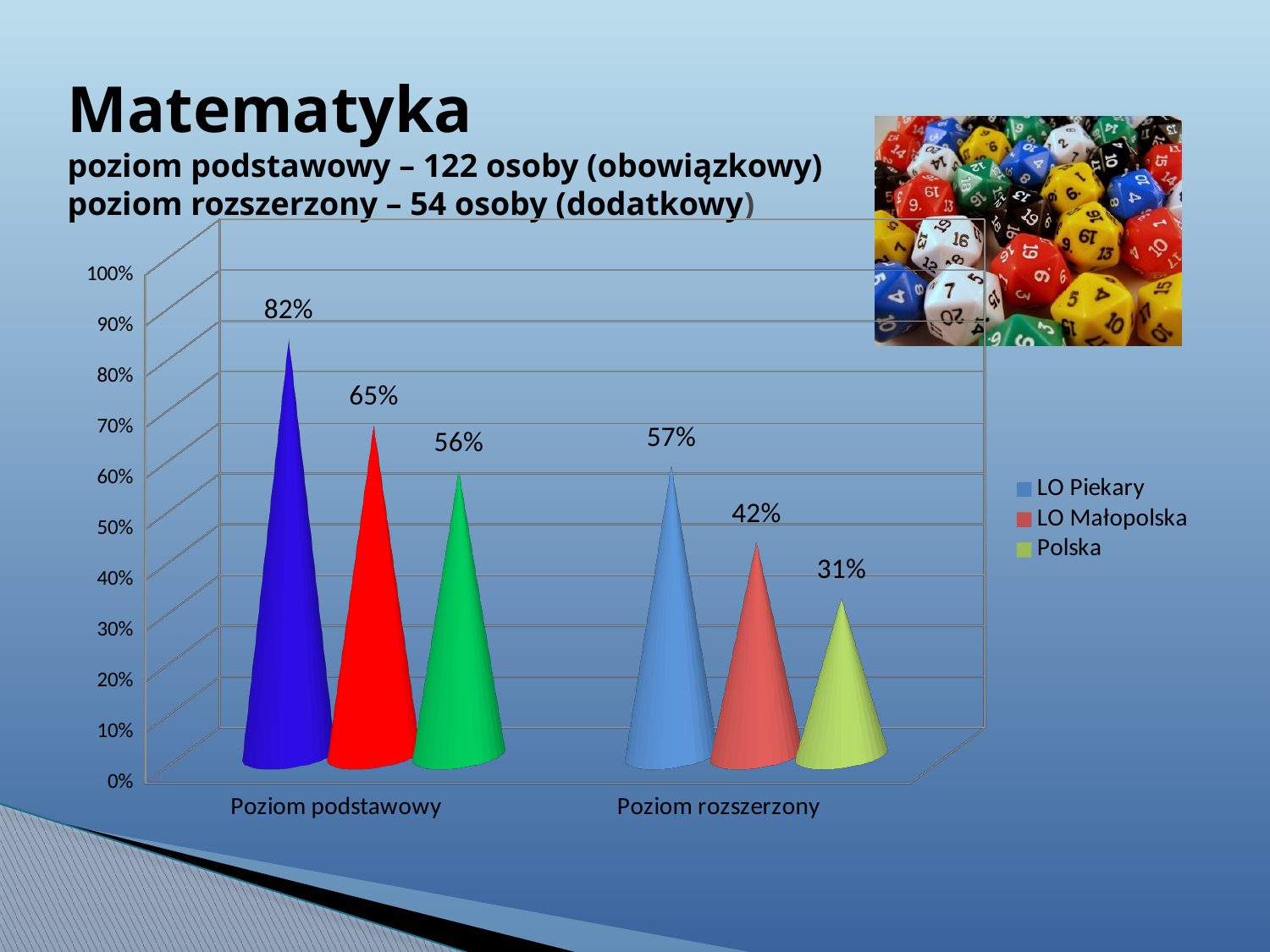
What is the value for LO Piekary in the Poziom rozszerzony category? 57% Which is larger: LO Małopolska in Poziom podstawowy or LO Piekary in Poziom rozszerzony? LO Małopolska in Poziom podstawowy What is the value for Polska in the Poziom rozszerzony category? 31% What is the difference between the LO Piekary and Polska values in the Poziom podstawowy category? 26% What is the difference between the LO Małopolska and Polska values in the Poziom rozszerzony category? 11% What kind of chart is shown on the slide? Bar chart How many series does the legend list? 3 What is the value for LO Małopolska in the Poziom podstawowy category? 65% Which series has the highest value in the Poziom rozszerzony category? LO Piekary What is the value for LO Piekary in the Poziom podstawowy category? 82% Which series has the lowest value in the Poziom podstawowy category? Polska How many categories are shown on the x axis? 2